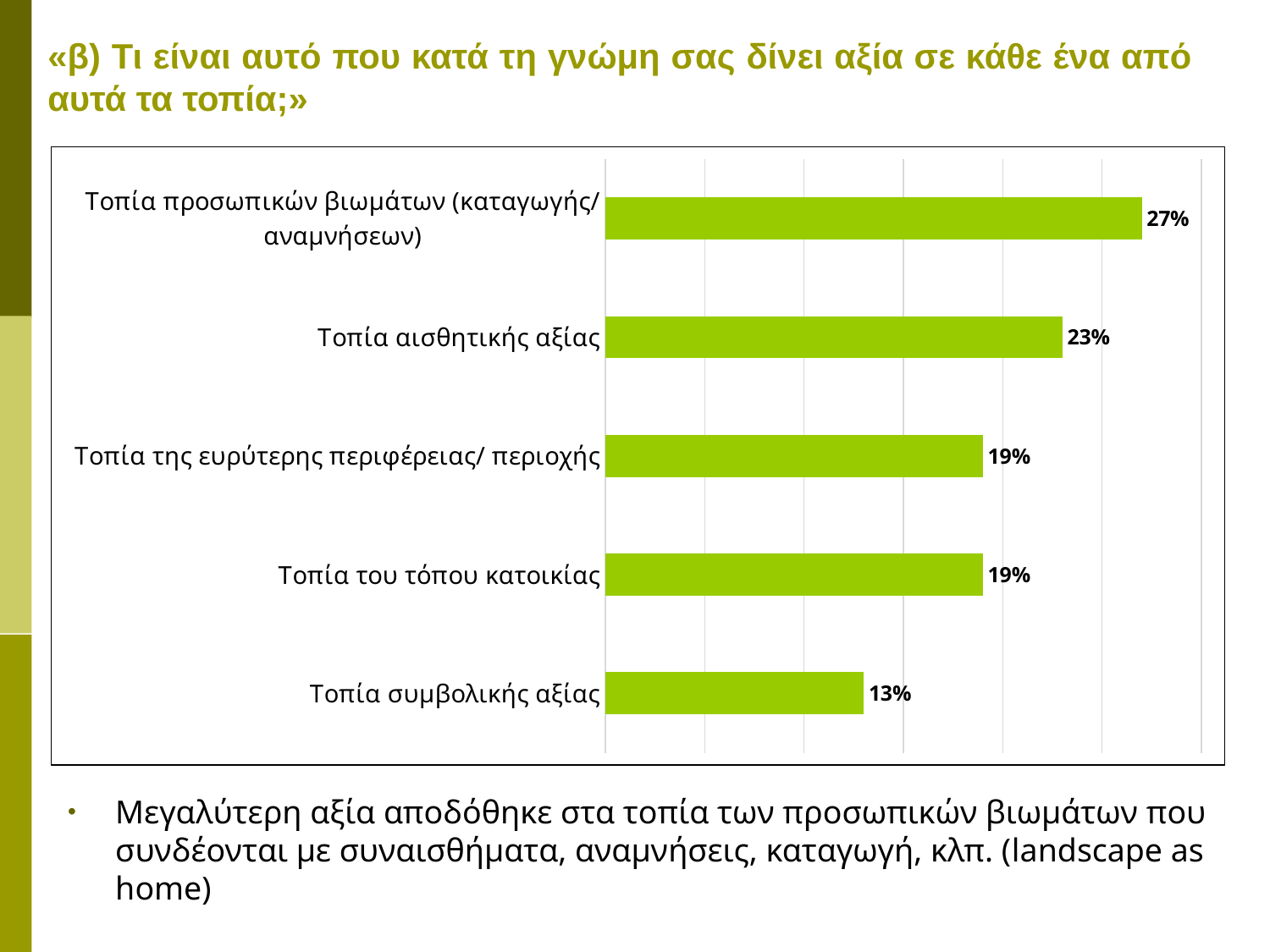
What value is shown for Τοπία συμβολικής αξίας? 13% Which is larger, the value for Τοπία αισθητικής αξίας or the value for Τοπία του τόπου κατοικίας? Τοπία αισθητικής αξίας What is the difference between the values for Τοπία προσωπικών βιωμάτων (καταγωγής/ αναμνήσεων) and Τοπία συμβολικής αξίας? 14% What is the difference between the values for Τοπία αισθητικής αξίας and Τοπία της ευρύτερης περιφέρειας/ περιοχής? 4% What value is shown for Τοπία προσωπικών βιωμάτων (καταγωγής/ αναμνήσεων)? 27% What value is shown for Τοπία του τόπου κατοικίας? 19% How many categories are shown in the chart? 5 What value is shown for Τοπία αισθητικής αξίας? 23% What kind of chart is shown on the slide? Bar chart Which category has the highest value? Τοπία προσωπικών βιωμάτων (καταγωγής/ αναμνήσεων) What colour are the bars in the chart? Green Which category has the lowest value? Τοπία συμβολικής αξίας